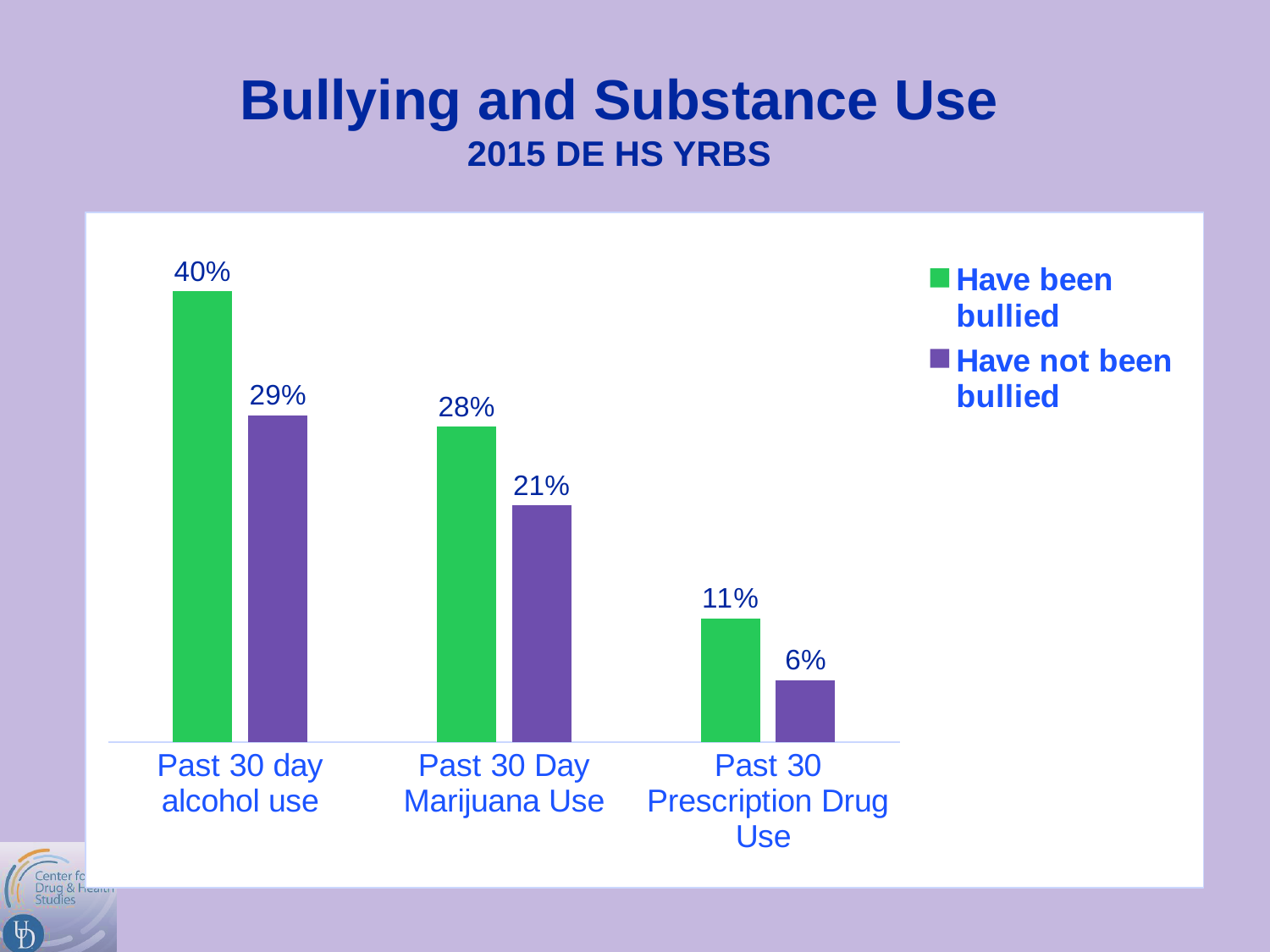
Which colour represents students who have been bullied? Green What percentage of students who have been bullied reported past 30 day alcohol use? 40% For past 30 prescription drug use, which group has the larger value: students who have been bullied or students who have not been bullied? Have been bullied Which category has the highest value for students who have been bullied? Past 30 day alcohol use How many series does the legend list? 2 How many substance use categories are shown on the x axis? 3 What is the value for 'Have not been bullied' in the Past 30 Prescription Drug Use category? 6% Which category has the lowest value for students who have not been bullied? Past 30 Prescription Drug Use What percentage of students who have not been bullied reported past 30 day marijuana use? 21% What kind of chart is shown on the slide? Bar chart What is the difference between the 'Have been bullied' and 'Have not been bullied' values for past 30 day marijuana use? 7% What is the difference between the 'Have been bullied' and 'Have not been bullied' values for past 30 day alcohol use? 11%